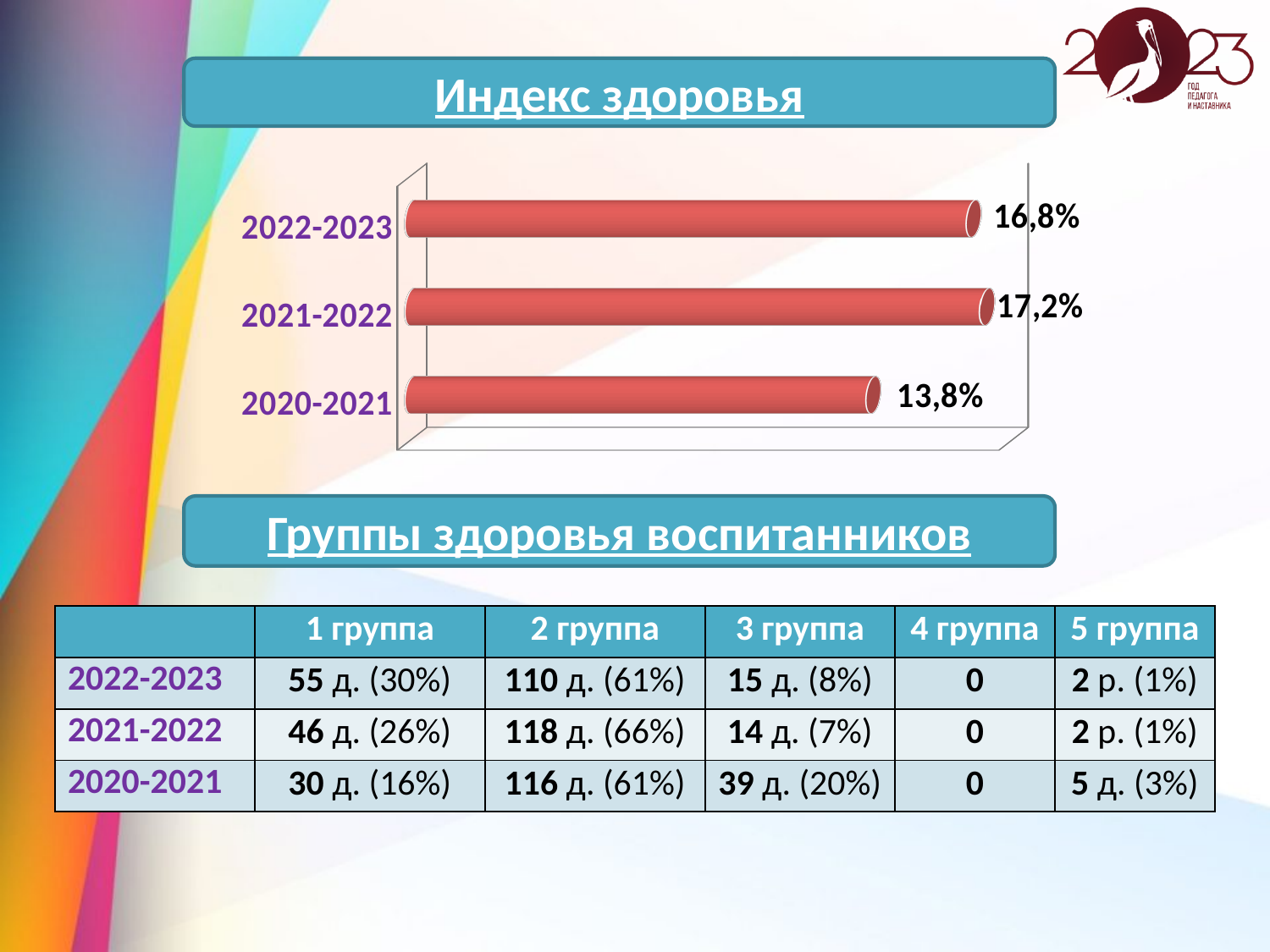
What type of chart is the Индекс здоровья chart? Bar chart In the Индекс здоровья chart, what is the difference between the values for 2021-2022 and 2022-2023? 0,4% In the Индекс здоровья chart, which is larger: the value for 2022-2023 or the value for 2020-2021? 2022-2023 In the Индекс здоровья chart, what is the difference between the values for 2021-2022 and 2020-2021? 3,4% What is the value for 2021-2022 in the Индекс здоровья chart? 17,2% What is the value for 2022-2023 in the Индекс здоровья chart? 16,8% Which period has the lowest value in the Индекс здоровья chart? 2020-2021 What is the title of the chart on the slide? Индекс здоровья Which period has the highest value in the Индекс здоровья chart? 2021-2022 How many periods are shown in the Индекс здоровья chart? 3 In the Индекс здоровья chart, what is the difference between the values for 2022-2023 and 2020-2021? 3,0% What is the value for 2020-2021 in the Индекс здоровья chart? 13,8%